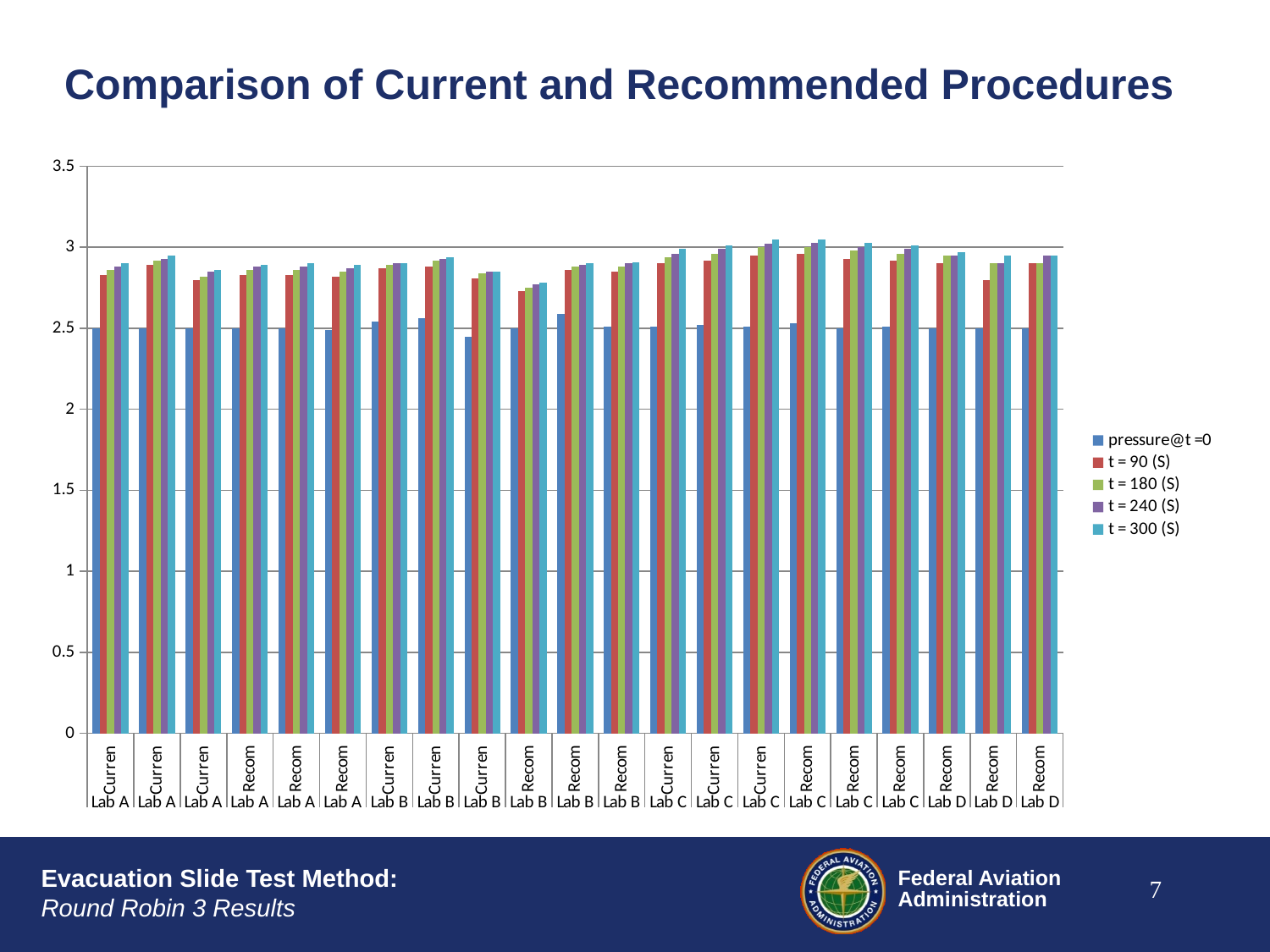
What kind of chart is shown on the slide? bar chart Within the first Lab A Curren group, do the values rise or fall from t = 90 (S) to t = 300 (S)? rise Is the value for t = 90 (S) in the first Lab A Curren group greater or less than 2.5? greater Is the value for t = 90 (S) in the first Lab B Recom group greater or less than 3? less What is the title of the chart? Comparison of Current and Recommended Procedures How many category groups are shown along the x axis? 21 Which is larger: the t = 90 (S) value in the first Lab B Recom group or the t = 90 (S) value in the first Lab C Recom group? first Lab C Recom group How many series does the legend list? 5 Is the value for pressure@t =0 in the first Lab A Curren group greater or less than 2? greater What is the first entry in the legend? pressure@t =0 How many different labs are shown on the x axis? 4